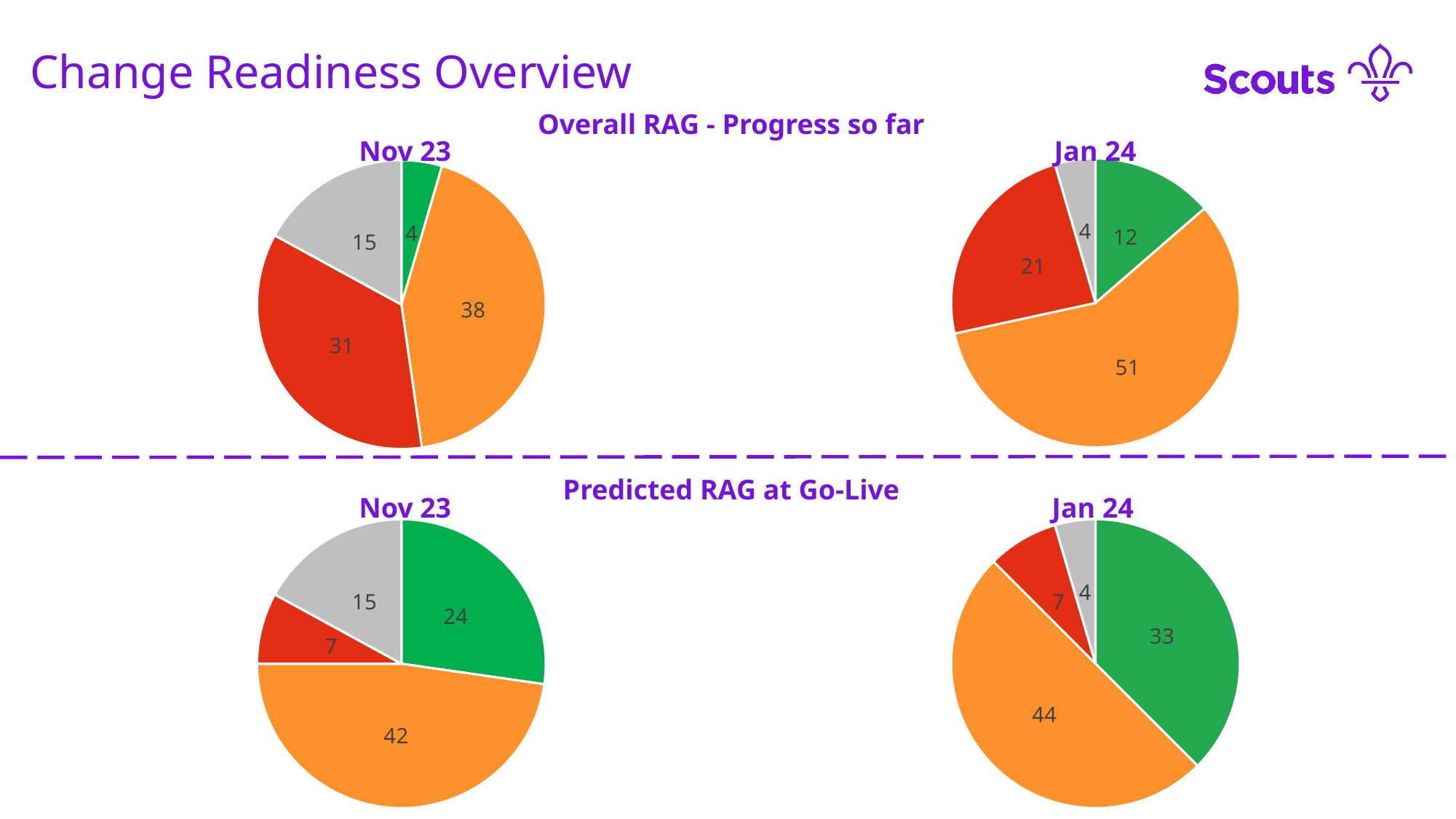
What is the difference between the red slice values in the Overall RAG - Progress so far charts for Nov 23 and Jan 24? 10 How many pie charts are shown on the slide in total? 4 What is the total of all slice values in the Predicted RAG at Go-Live chart for Nov 23? 88 In the Overall RAG - Progress so far chart for Jan 24, what value is shown on the red slice? 21 In the Overall RAG - Progress so far chart for Nov 23, what value is shown on the orange slice? 38 In the Overall RAG - Progress so far chart for Nov 23, which slice has the smallest value? Green (4) In the Overall RAG - Progress so far chart for Jan 24, which slice has the largest value? Orange (51) In the Predicted RAG at Go-Live charts, is the green slice larger for Nov 23 or Jan 24? Jan 24 What type of chart is used in the Overall RAG - Progress so far section? Pie chart In the Predicted RAG at Go-Live chart for Jan 24, what value is shown on the grey slice? 4 How many slices does the Predicted RAG at Go-Live chart for Jan 24 have? 4 In the Predicted RAG at Go-Live chart for Nov 23, what value is shown on the green slice? 24